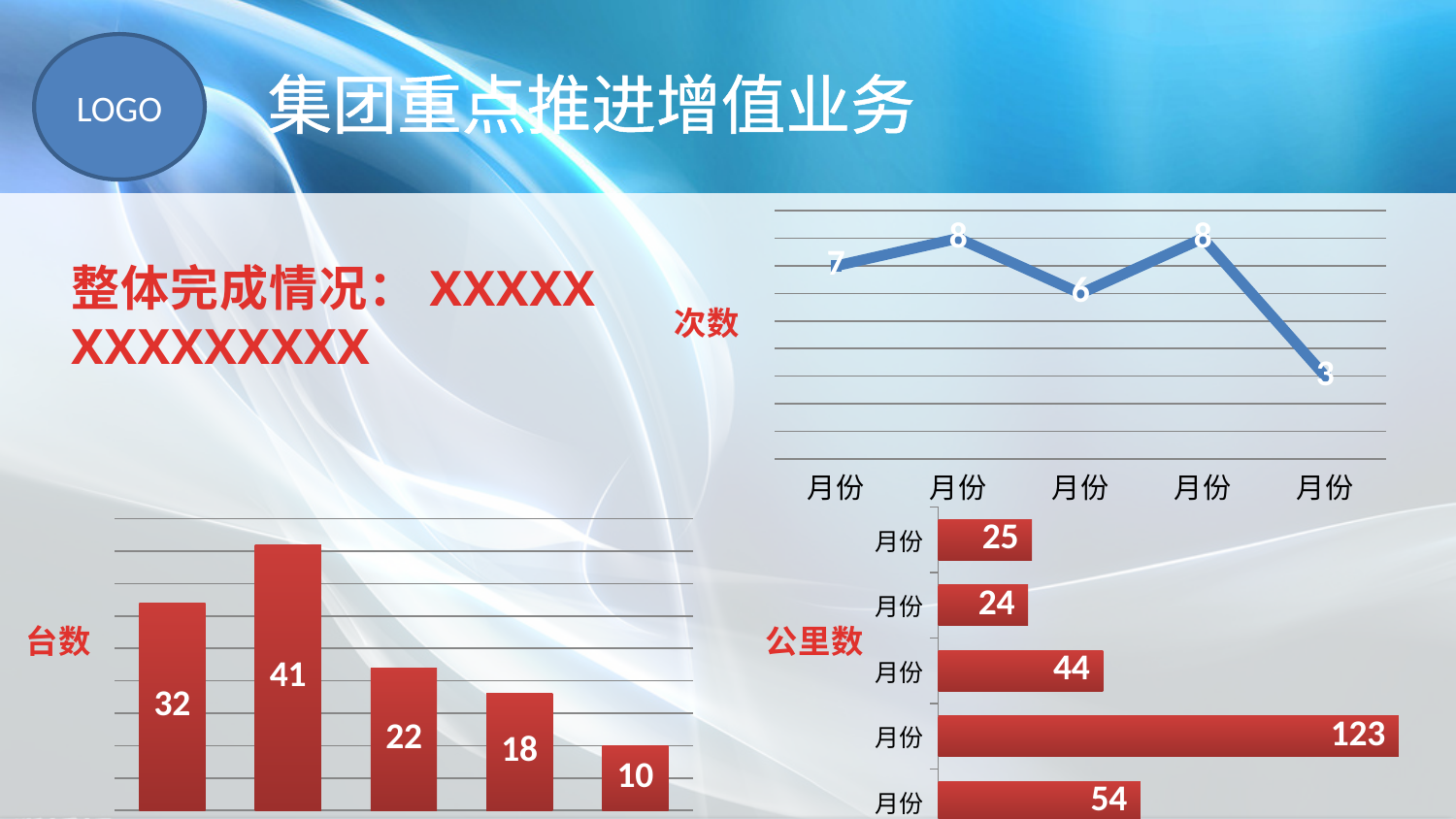
On the 公里数 chart at the bottom right, what is the smallest value shown? 24 On the 次数 line chart at the top right, how many data points are plotted? 5 On the 台数 chart at the bottom left, what is the difference between the first bar and the third bar? 10 On the 公里数 chart at the bottom right, which is larger: the third bar (44) or the fifth bar (54)? the fifth bar, 54 On the 次数 line chart at the top right, what is the value of the first point? 7 On the 公里数 chart at the bottom right, what is the largest value shown? 123 What kind of chart is the 台数 chart at the bottom left? bar chart On the 次数 line chart at the top right, what is the value of the last (fifth) point? 3 On the 台数 chart at the bottom left, what is the value of the last (fifth) bar? 10 What kind of chart is the 次数 chart at the top right? line chart On the 次数 line chart at the top right, what is the difference between the fourth point and the fifth point? 5 On the 台数 chart at the bottom left, which bar is the tallest and what is its value? the second bar, 41